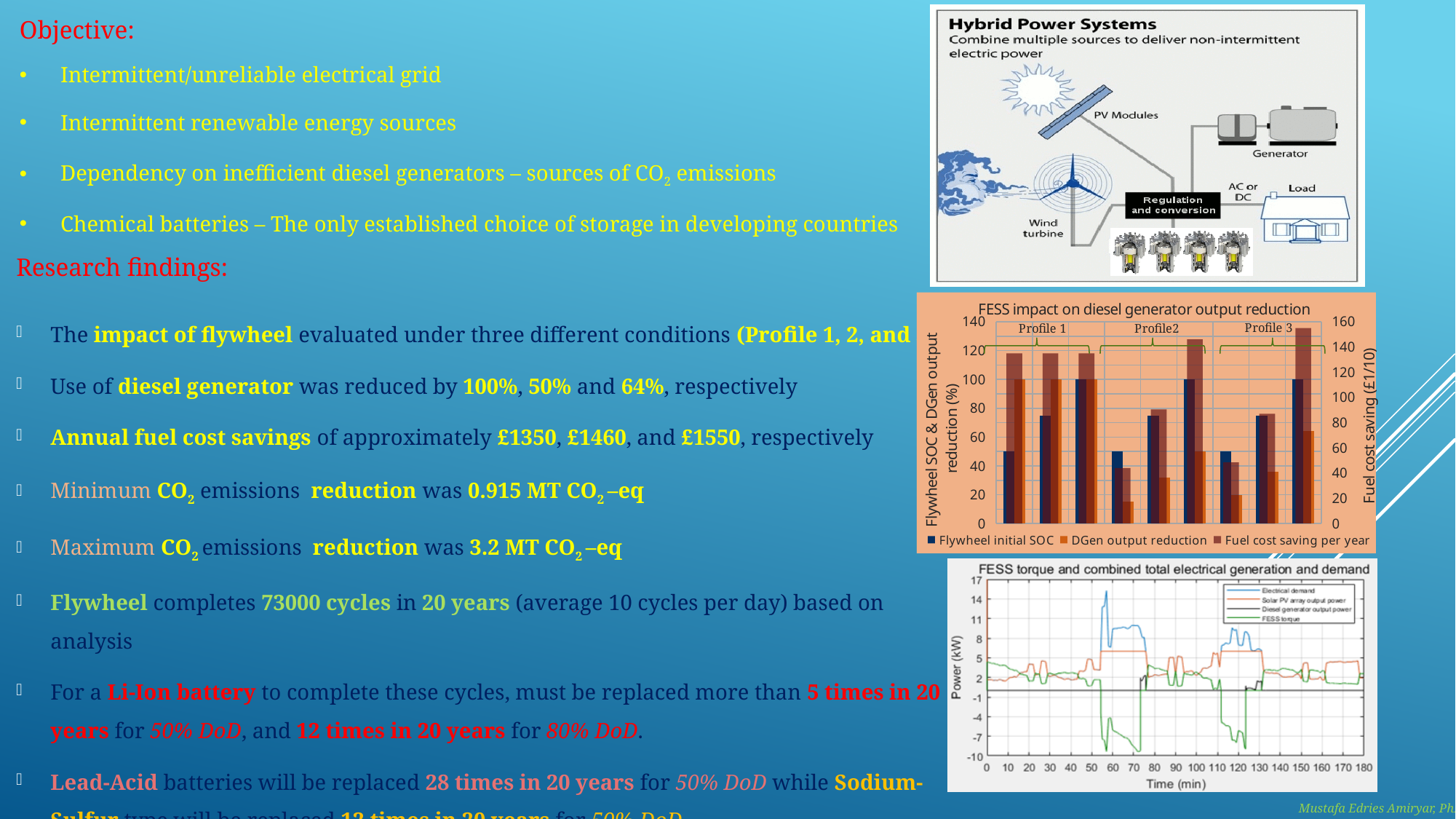
How many series does the legend of the 'FESS torque and combined total electrical generation and demand' chart list? 4 How many series does the legend of the 'FESS impact on diesel generator output reduction' chart list? 3 What kind of chart is the 'FESS impact on diesel generator output reduction' chart? bar chart In the 'FESS impact on diesel generator output reduction' chart, is the fuel cost saving per year for the first group of Profile 2 greater or less than 20? greater In the 'FESS impact on diesel generator output reduction' chart, which profile has the highest fuel cost saving per year bar? Profile 3 In the 'FESS impact on diesel generator output reduction' chart, what are the three series named in the legend? Flywheel initial SOC, DGen output reduction, Fuel cost saving per year In the 'FESS impact on diesel generator output reduction' chart, is the fuel cost saving per year for the third group of Profile 3 greater or less than 140? greater In the 'FESS impact on diesel generator output reduction' chart, what is the label of the right-hand vertical axis? Fuel cost saving (£1/10) In the 'FESS torque and combined total electrical generation and demand' chart, what is the label of the x axis? Time (min) In the 'FESS impact on diesel generator output reduction' chart, what is the DGen output reduction value for each group in Profile 1? 100 What kind of chart is the 'FESS torque and combined total electrical generation and demand' chart? line chart In the 'FESS impact on diesel generator output reduction' chart, how many profiles are shown along the x axis? 3